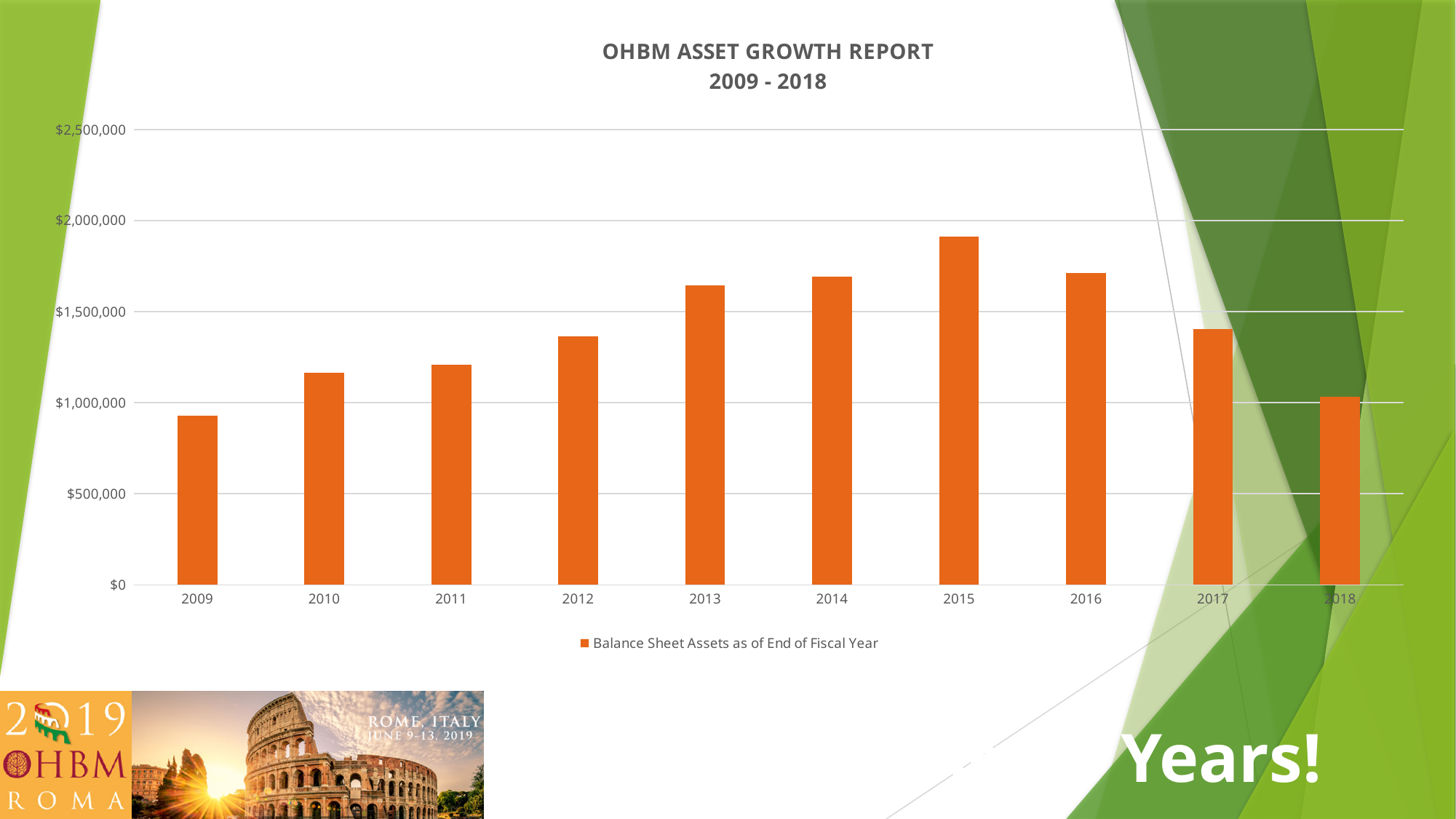
Do the balance sheet assets rise or fall from 2009 to 2015? rise Is the value for 2015 greater or less than $2,000,000? less How many series does the chart legend list? 1 Is the value for 2009 greater or less than $1,000,000? less What is the title of the chart? OHBM ASSET GROWTH REPORT 2009 - 2018 Is the value for 2017 greater or less than $1,500,000? less How many years are plotted on the x axis of the chart? 10 Which year has higher balance sheet assets, 2015 or 2016? 2015 Which year has the lowest balance sheet assets? 2009 Which year has the highest balance sheet assets? 2015 What kind of chart is shown on the slide? Bar chart